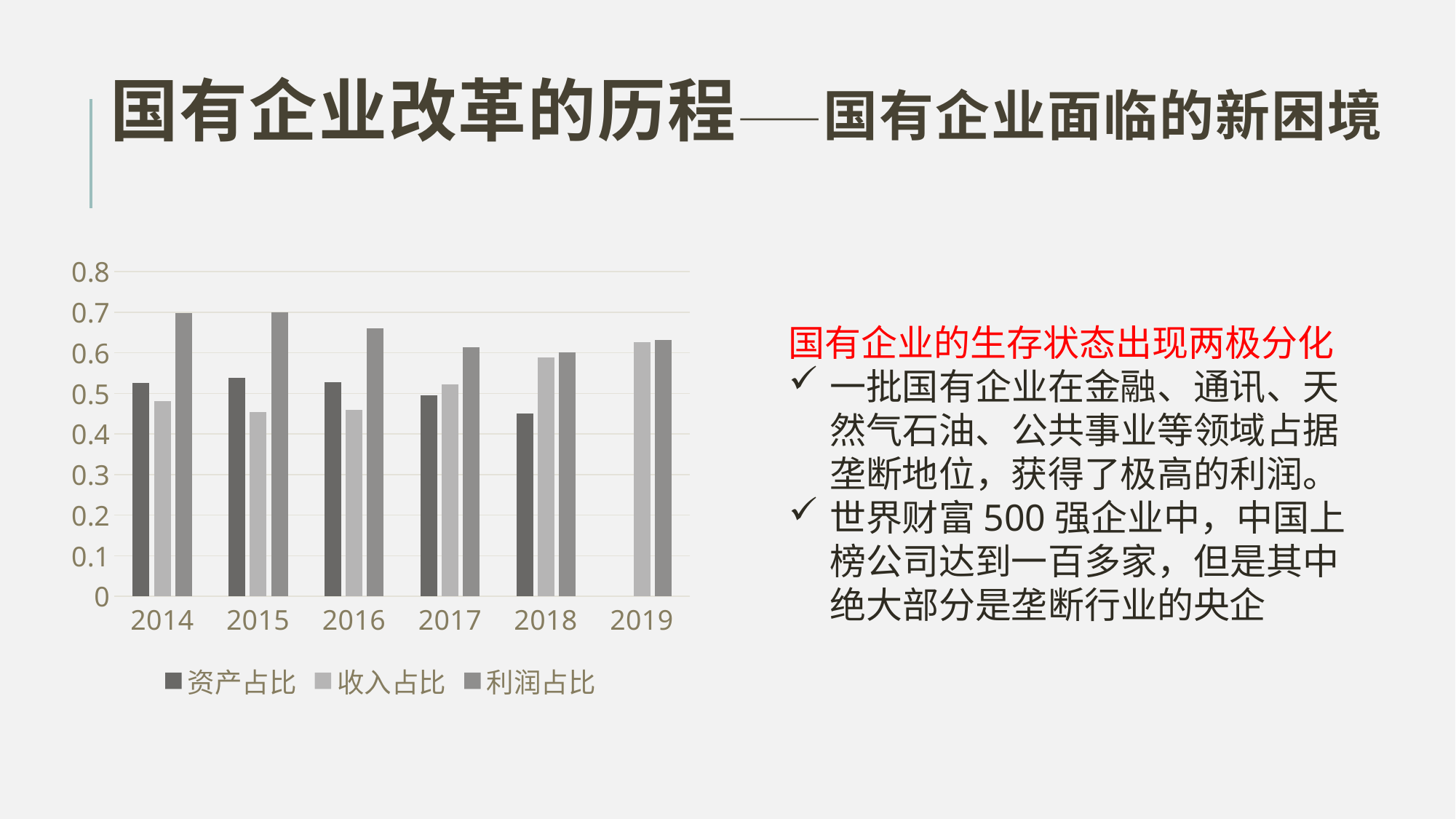
How many years are shown on the x axis of the chart? 6 Is the value of 利润占比 for 2014 greater or less than 0.6? greater In 2018, which is larger: 收入占比 or 资产占比? 收入占比 Is the value of 收入占比 for 2015 greater or less than 0.5? less Is the value of 资产占比 for 2018 greater or less than 0.5? less What are the three series listed in the chart legend? 资产占比, 收入占比, 利润占比 What kind of chart is shown on the slide? bar chart Does 收入占比 rise or fall from 2015 to 2019? rise How many series does the chart legend list? 3 In which year is 收入占比 the highest? 2019 In 2014, which is larger: 利润占比 or 资产占比? 利润占比